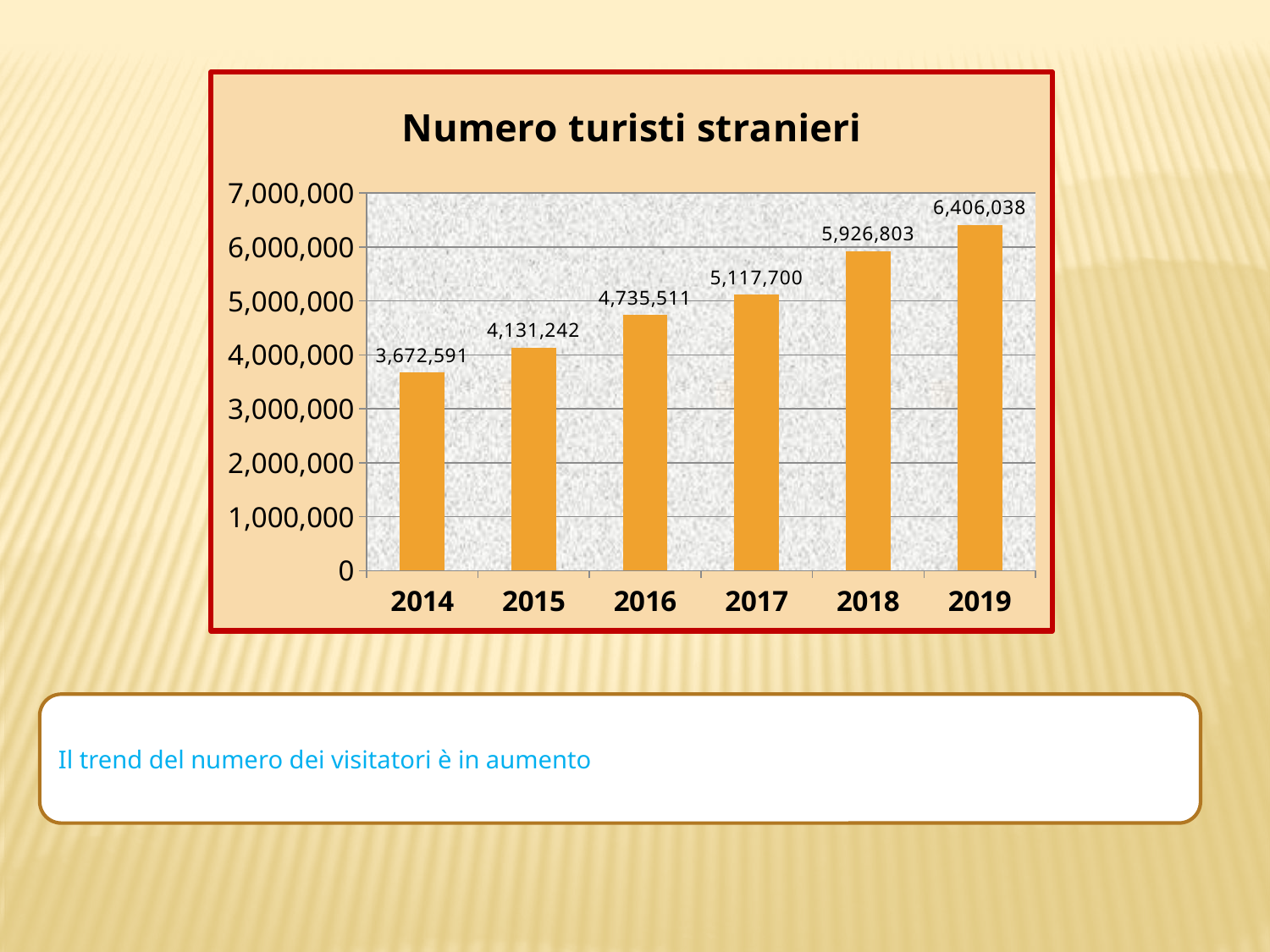
What is the value for 2014? 3,672,591 How many years are shown on the x axis? 6 What kind of chart is shown? bar chart What is the difference between the values for 2018 and 2017? 809,103 Is the value for 2018 greater or less than 5,000,000? greater Which year has the lowest value? 2014 Do the values rise or fall from 2014 to 2019? rise Which year has the highest value? 2019 Which is larger, the value for 2016 or the value for 2015? 2016 What is the difference between the values for 2019 and 2014? 2,733,447 What is the value for 2019? 6,406,038 What is the value for 2017? 5,117,700